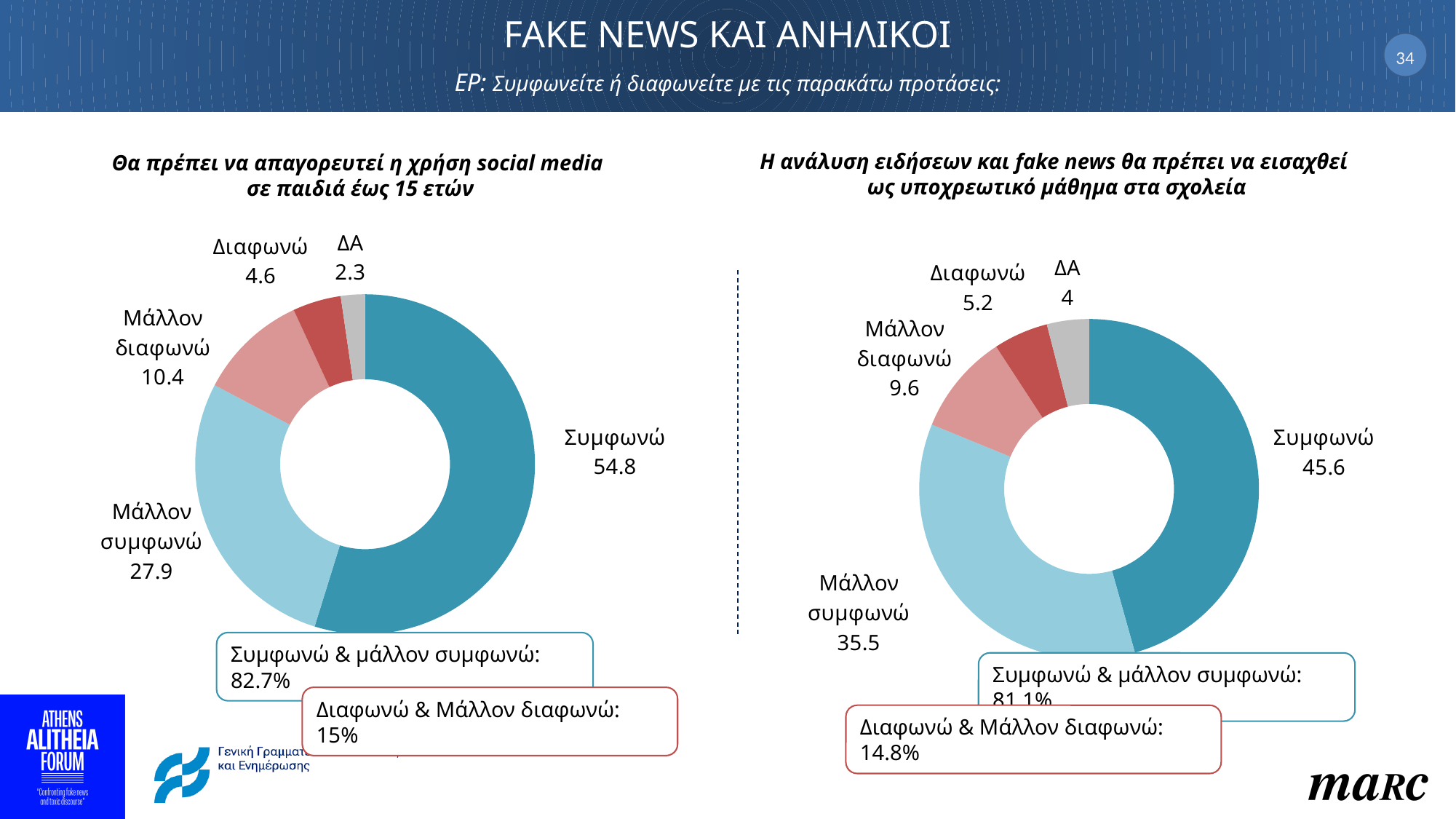
In the left chart (social media ban for children up to 15), what is the difference between Συμφωνώ and Μάλλον συμφωνώ? 26.9 In the left chart (social media ban for children up to 15), what is the value for Συμφωνώ? 54.8 How many categories does the left chart (social media ban for children up to 15) show? 5 In the left chart (social media ban for children up to 15), which category has the smallest value? ΔΑ According to the callout box under the left chart, what is the combined share of Συμφωνώ & μάλλον συμφωνώ? 82.7% According to the callout box under the right chart, what is the combined share of Διαφωνώ & Μάλλον διαφωνώ? 14.8% In the right chart (fake news analysis as a mandatory school subject), what is the difference between Μάλλον διαφωνώ and Διαφωνώ? 4.4 What type of chart is used on the right side of the slide? Donut (pie) chart In the right chart (fake news analysis as a mandatory school subject), which category has the largest value? Συμφωνώ In the right chart (fake news analysis as a mandatory school subject), what is the value for ΔΑ? 4 Which is larger: Διαφωνώ in the left chart or Διαφωνώ in the right chart? Διαφωνώ in the right chart In the right chart (fake news analysis as a mandatory school subject), what is the value for Μάλλον συμφωνώ? 35.5